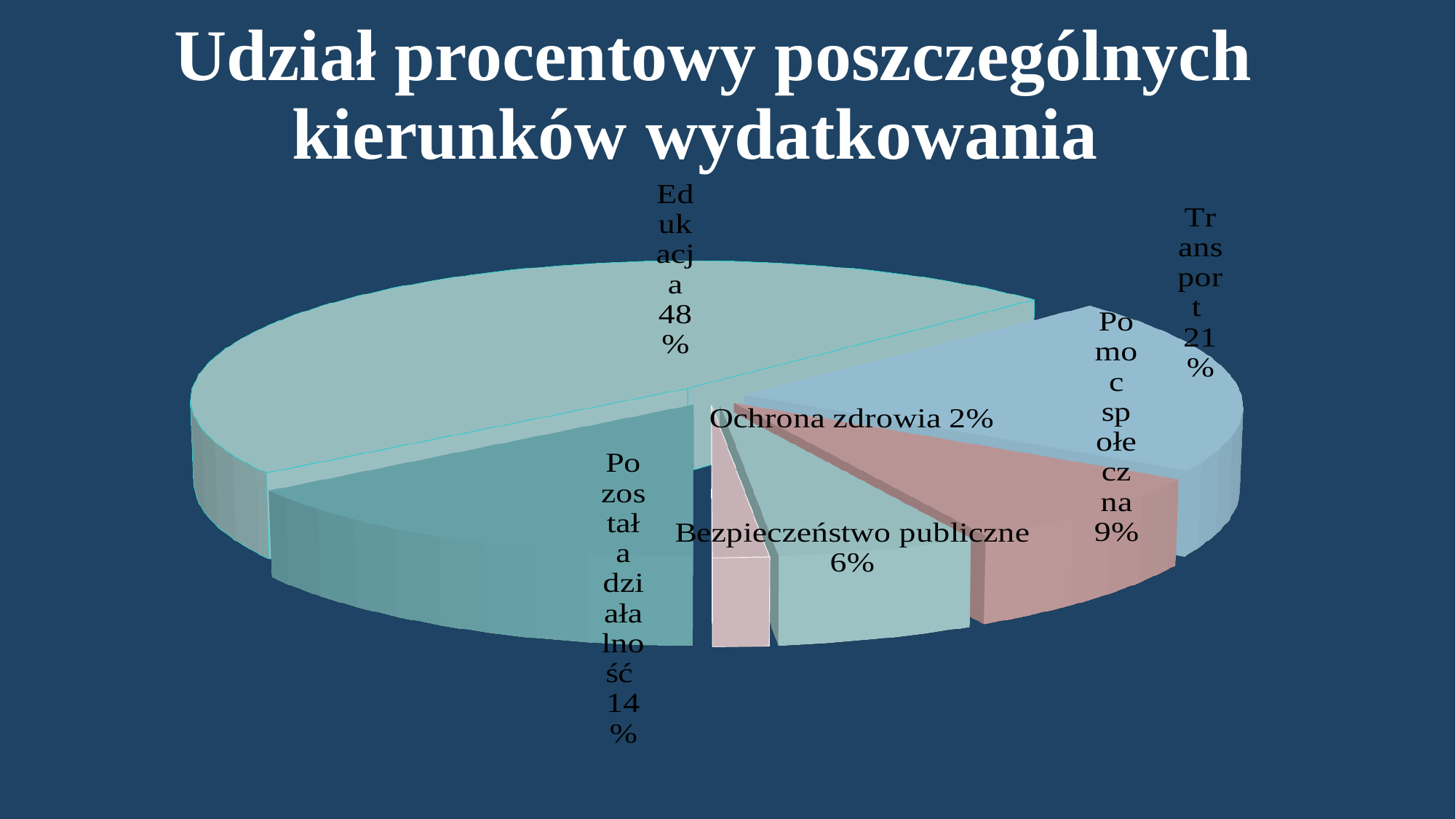
What type of chart is shown on the slide? pie chart What percentage share does Transport have in the pie chart? 21% What percentage share does Pozostała działalność have in the pie chart? 14% How many categories (slices) does the pie chart have? 6 What is the title of the chart on the slide? Udział procentowy poszczególnych kierunków wydatkowania Which category has the largest share of the pie chart? Edukacja What percentage share does Bezpieczeństwo publiczne have in the pie chart? 6% What percentage share does Ochrona zdrowia have in the pie chart? 2% What percentage share does Edukacja have in the pie chart? 48% Which category has the smallest share of the pie chart? Ochrona zdrowia What is the difference in percentage points between the Edukacja and Transport shares? 27 What percentage share does Pomoc społeczna have in the pie chart? 9%